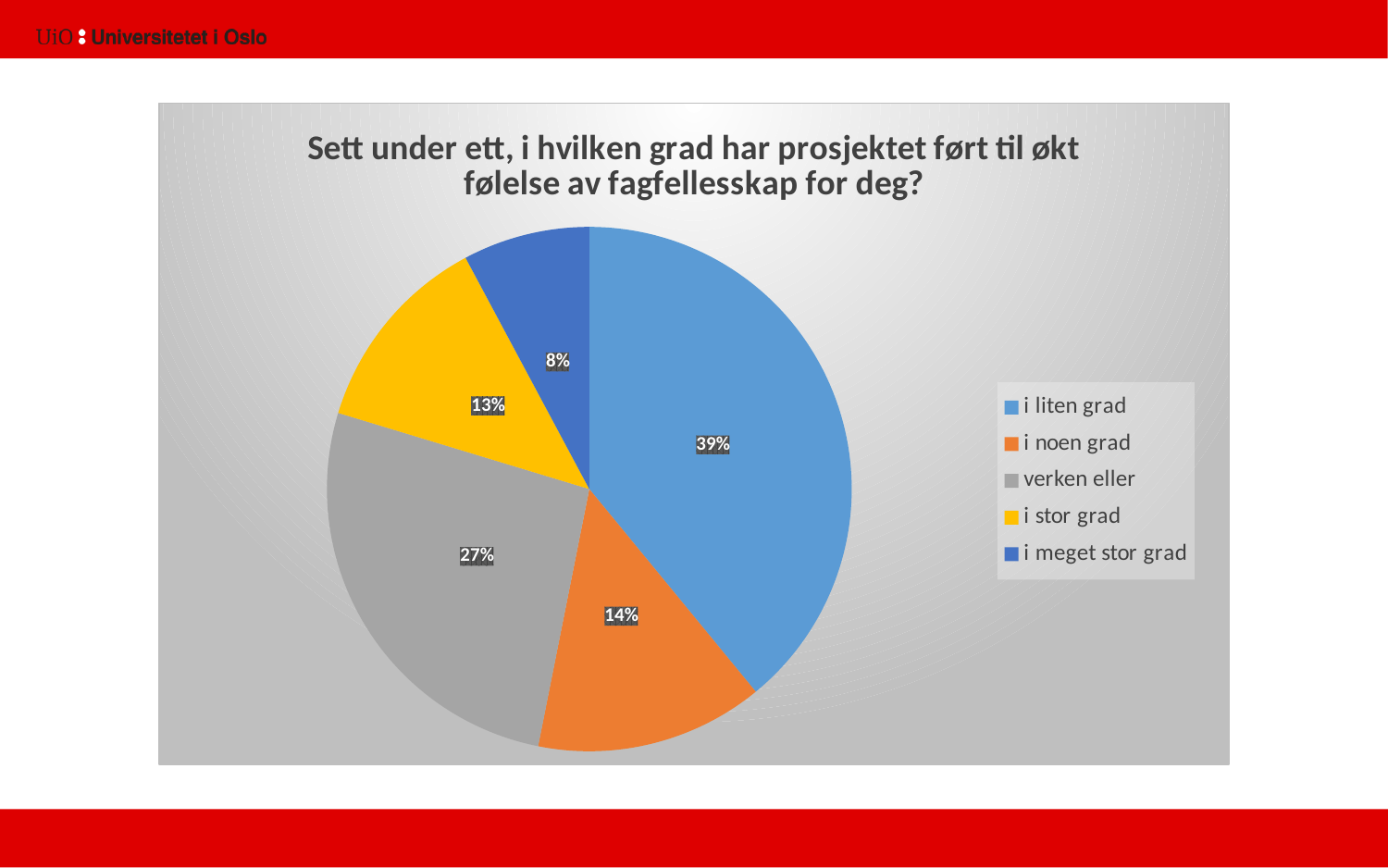
Which is larger, the slice for "i noen grad" or the slice for "i stor grad"? i noen grad What kind of chart is shown on the slide? pie chart What share of the pie does "i liten grad" represent? 39% What colour is the slice for "i stor grad"? yellow What is the difference in percentage points between "i liten grad" and "verken eller"? 12 How many categories does the pie chart have? 5 What share of the pie does "verken eller" represent? 27% Which category has the smallest slice of the pie? i meget stor grad What share of the pie does "i stor grad" represent? 13% Which category has the largest slice of the pie? i liten grad